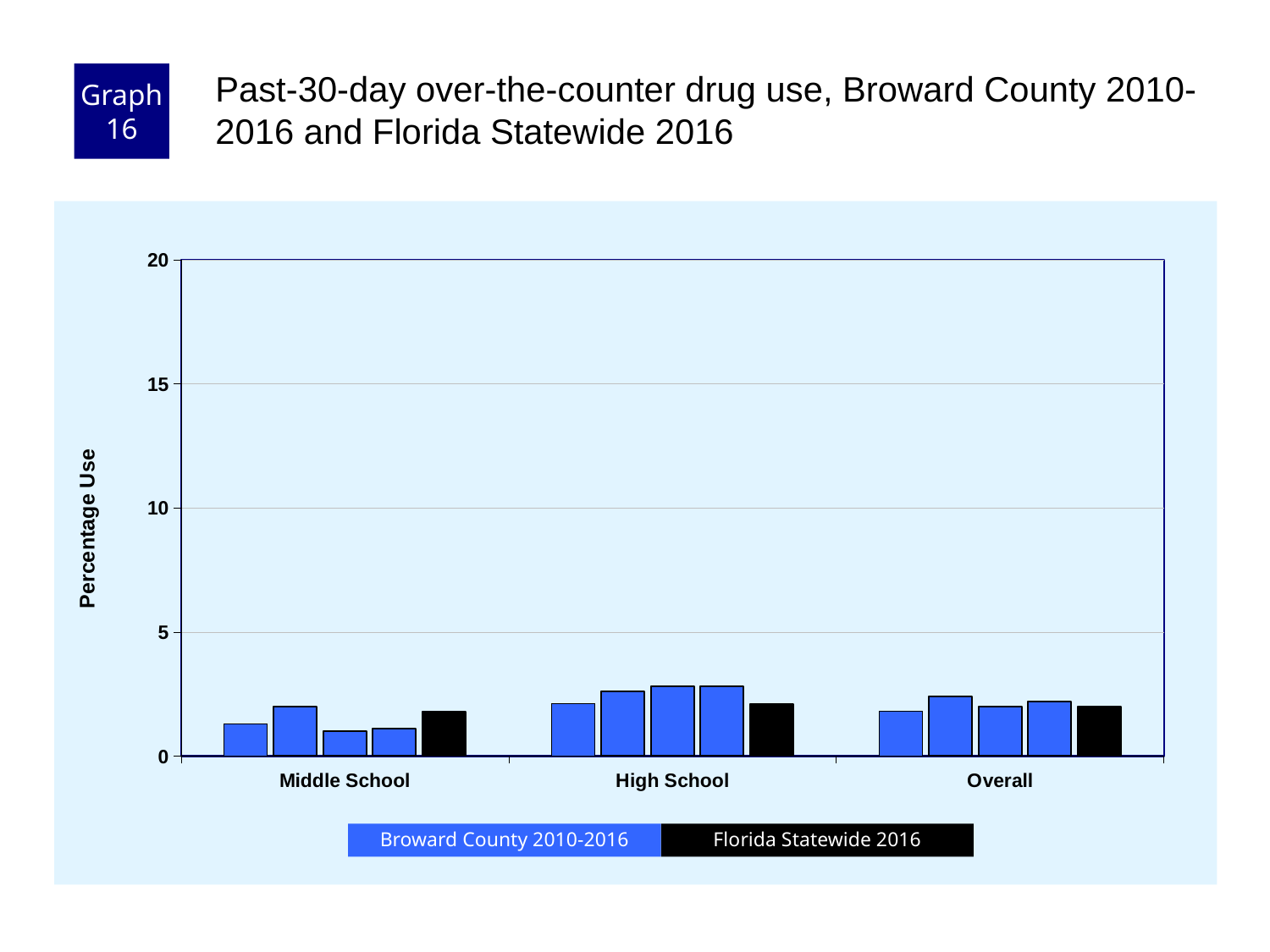
What kind of chart is shown on the slide? bar chart Is the value for Florida Statewide 2016 in the Overall category greater or less than 5? less Is the Florida Statewide 2016 bar larger for Middle School or for High School? High School Which category has the tallest bars overall? High School Is the value for Florida Statewide 2016 in the High School category greater or less than 5? less Is the first Broward County bar larger for Middle School or for High School? High School Which category has the shortest bars overall? Middle School How many series does the legend list? 2 Are any of the bars in the Middle School category greater than 5? No How many categories are shown on the x axis? 3 What is the label of the y axis? Percentage Use Which series is shown in black? Florida Statewide 2016